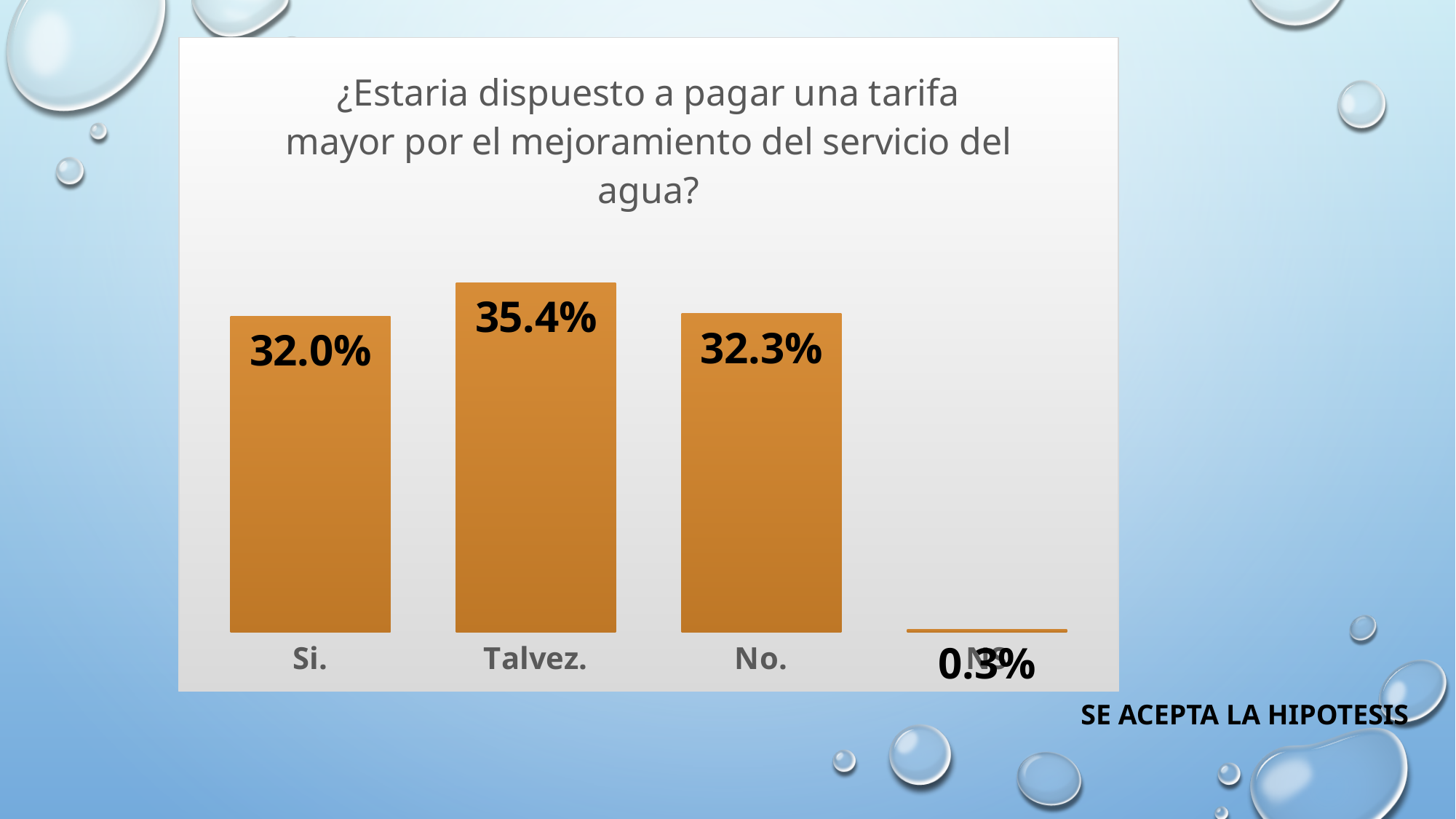
What colour are the bars in the chart? orange What kind of chart is shown on the slide? bar chart What is the lowest value shown in the chart? 0.3% Which category has the highest value? Talvez. What is the difference between the values for Talvez. and No.? 3.1% What is the title of the chart? ¿Estaria dispuesto a pagar una tarifa mayor por el mejoramiento del servicio del agua? What is the value for Talvez.? 35.4% How many bars (categories) does the chart show? 4 What is the value for No.? 32.3% Which is larger, the value for Talvez. or the value for No.? Talvez. What is the value for Si.? 32.0% What is the difference between the values for Talvez. and Si.? 3.4%